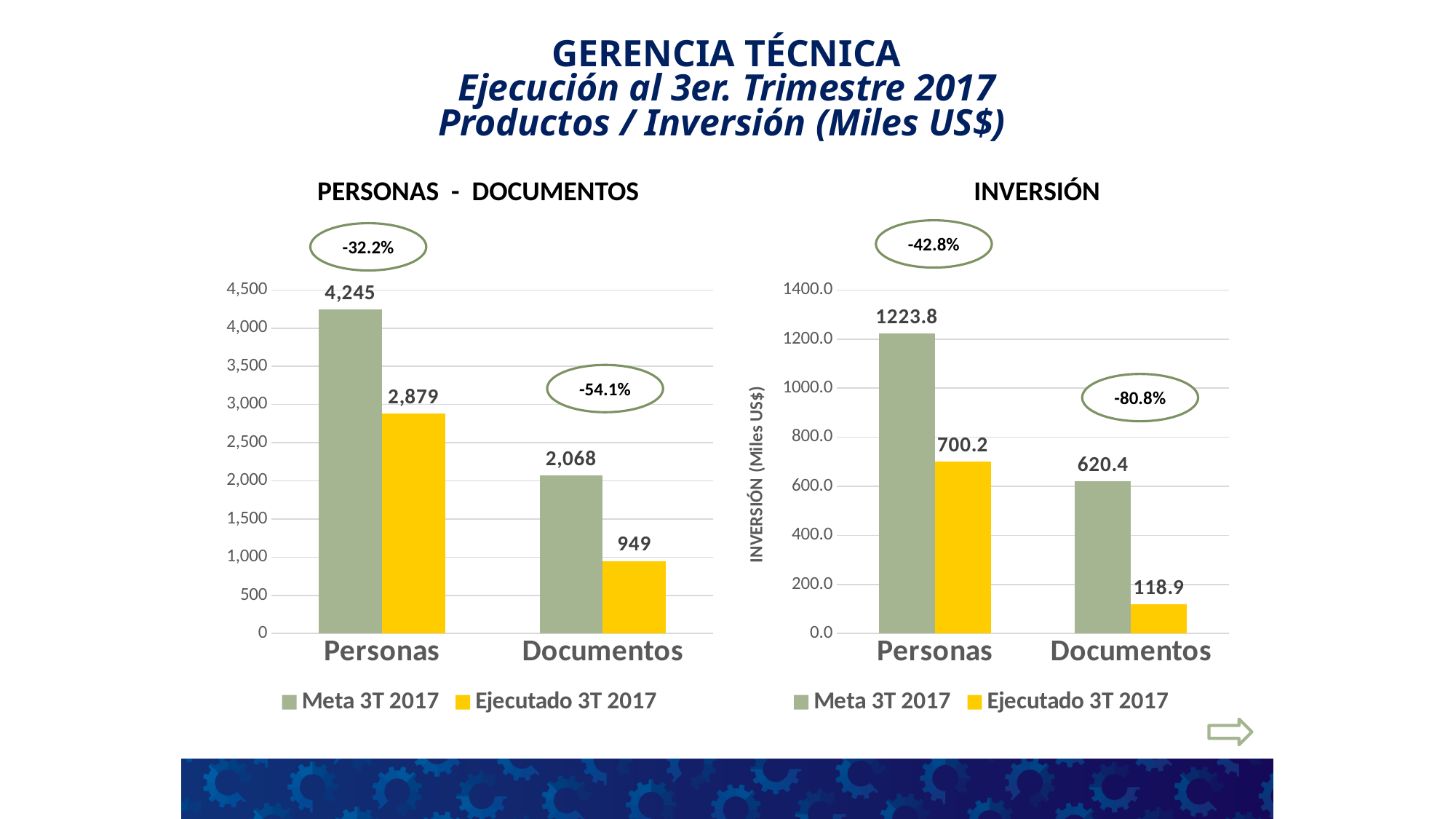
What kind of chart is the INVERSIÓN chart? Bar chart In the INVERSIÓN chart, what is the Ejecutado 3T 2017 value for Documentos? 118.9 In the PERSONAS - DOCUMENTOS chart, what is the Meta 3T 2017 value for Personas? 4,245 In the PERSONAS - DOCUMENTOS chart, what is the difference between the Meta 3T 2017 and Ejecutado 3T 2017 values for Personas? 1,366 In the INVERSIÓN chart, what is the Meta 3T 2017 value for Personas? 1223.8 How many categories are shown on the x axis of the PERSONAS - DOCUMENTOS chart? 2 In the INVERSIÓN chart, what is the difference between the Meta 3T 2017 and Ejecutado 3T 2017 values for Documentos? 501.5 How many series does the legend of the INVERSIÓN chart list? 2 In the INVERSIÓN chart, which bar is the lowest? Ejecutado 3T 2017 for Documentos What percentage is shown in the oval above the Documentos bars in the INVERSIÓN chart? -80.8% In the PERSONAS - DOCUMENTOS chart, which is larger: Ejecutado 3T 2017 for Personas or Meta 3T 2017 for Documentos? Ejecutado 3T 2017 for Personas In the PERSONAS - DOCUMENTOS chart, what is the Ejecutado 3T 2017 value for Documentos? 949